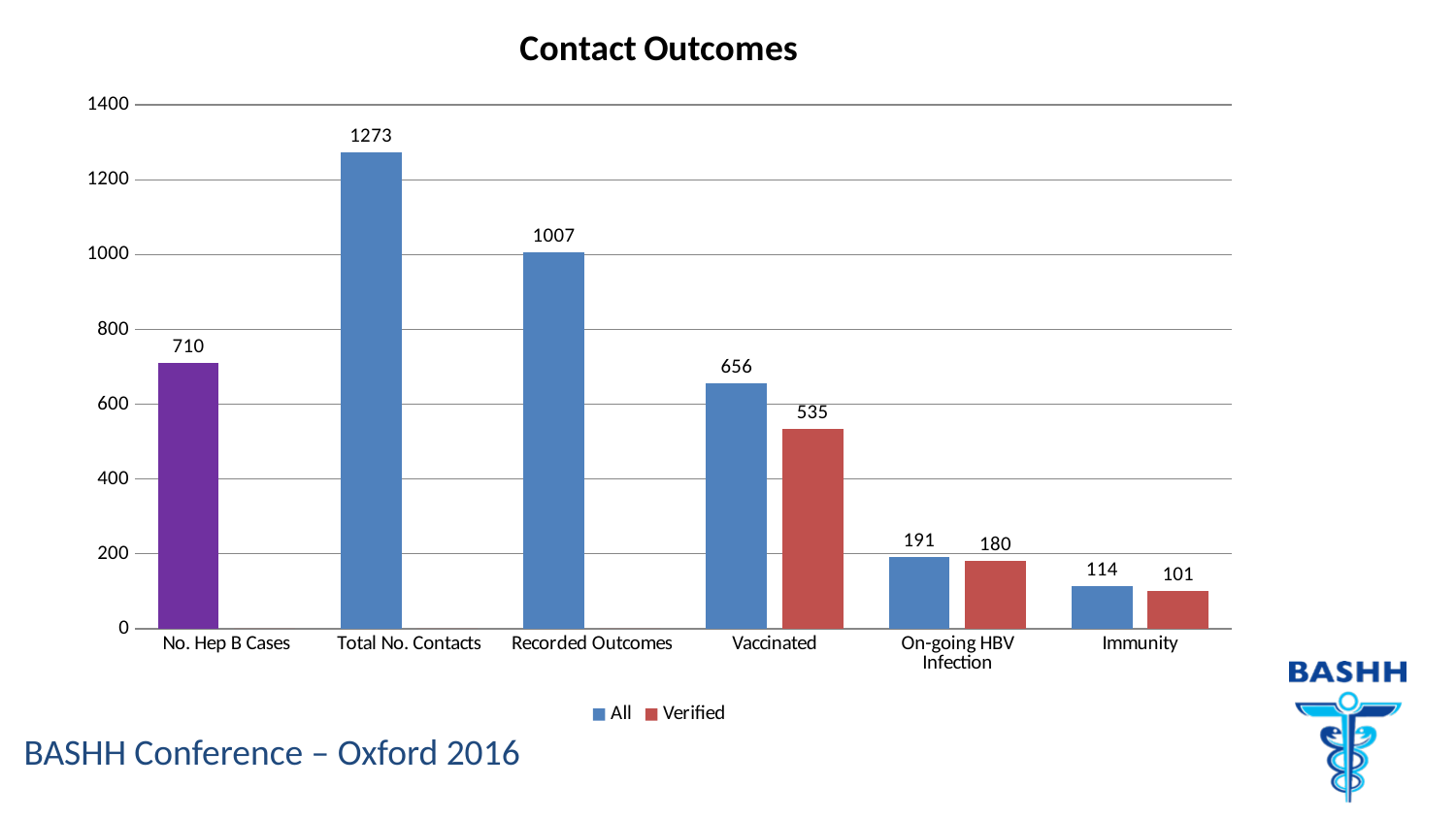
What is the difference between the All values for Total No. Contacts and Recorded Outcomes? 266 Which is larger, the All value for On-going HBV Infection or the Verified value for On-going HBV Infection? All What is the value for Total No. Contacts in the All series? 1273 What type of chart is shown? Bar chart What is the difference between the All and Verified values for Vaccinated? 121 What is the Verified value for Immunity? 101 What is the Verified value for Vaccinated? 535 How many categories are shown on the x axis? 6 What is the All value for Recorded Outcomes? 1007 Which category has the highest All value? Total No. Contacts How many series does the legend list? 2 Which category has the lowest Verified value? Immunity